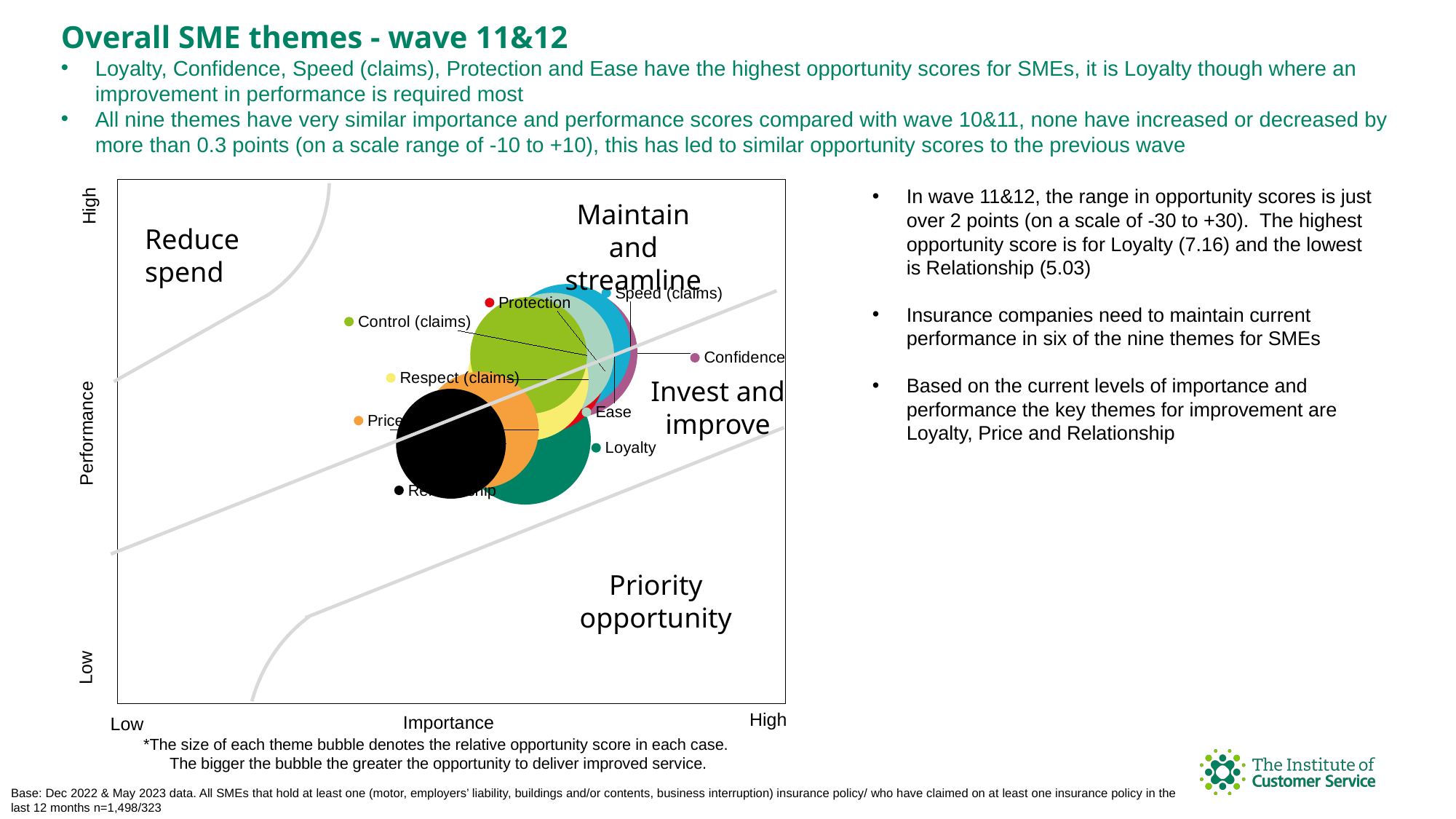
Which theme is plotted furthest to the right (highest importance) on the chart? Confidence Which theme has higher importance on the chart, Speed (claims) or Respect (claims)? Speed (claims) How many theme bubbles are plotted on the chart? 9 Which theme has higher performance on the chart, Control (claims) or Relationship? Control (claims) What kind of chart is shown on the slide? Bubble chart Which theme has higher importance on the chart, Price or Loyalty? Loyalty What is the label of the horizontal axis of the chart? Importance What is the label of the vertical axis of the chart? Performance